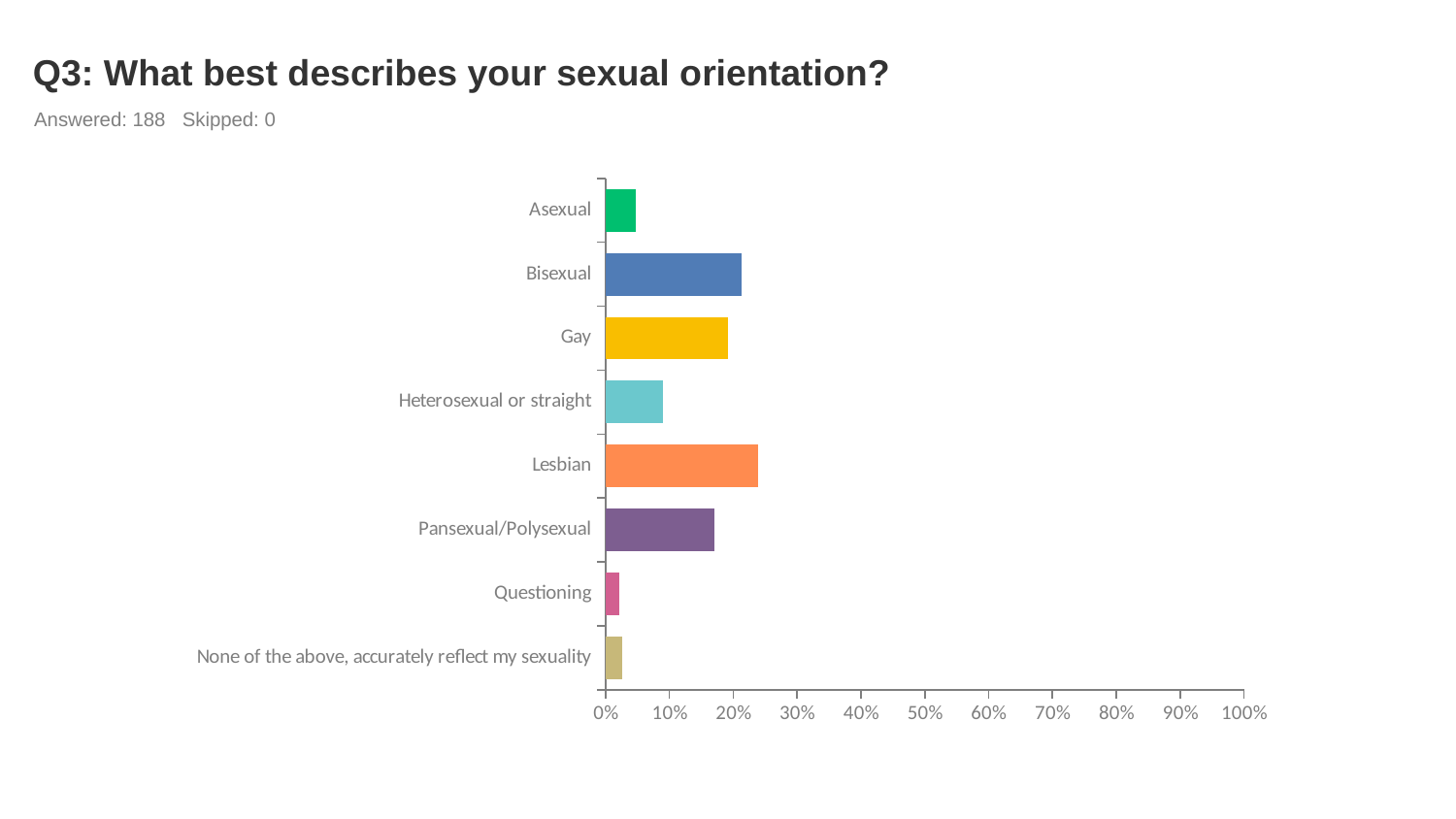
Is the value for Lesbian greater or less than 20%? greater Is the value for Asexual greater or less than 10%? less How many respondents answered the question according to the slide? 188 Is the value for Pansexual/Polysexual greater or less than 10%? greater Which is larger, the value for Heterosexual or straight or the value for Asexual? Heterosexual or straight What is the title of the chart? Q3: What best describes your sexual orientation? Which is larger, the value for Lesbian or the value for Pansexual/Polysexual? Lesbian How many categories are plotted in the chart? 8 What kind of chart is shown on the slide? bar chart Which category has the highest value in the chart? Lesbian